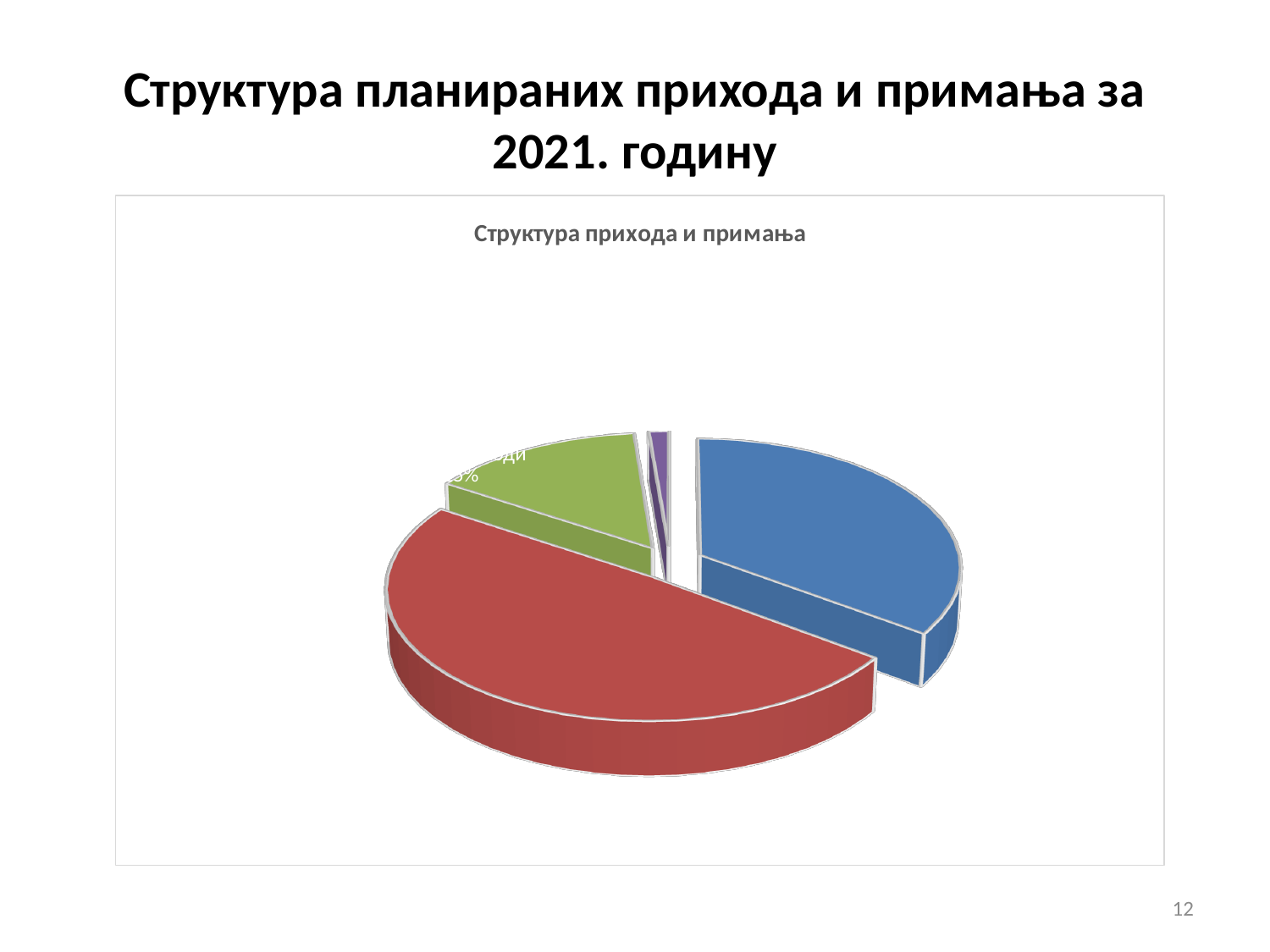
Which colour slice is the smallest in the pie chart? purple What is the title of the chart on the slide? Структура прихода и примања Which slice is larger, the red slice or the blue slice? red What kind of chart is shown on the slide? pie chart Which slice is larger, the green slice or the purple slice? green Does the chart display a legend? no Which slice is larger, the blue slice or the green slice? blue Which colour slice is the largest in the pie chart? red